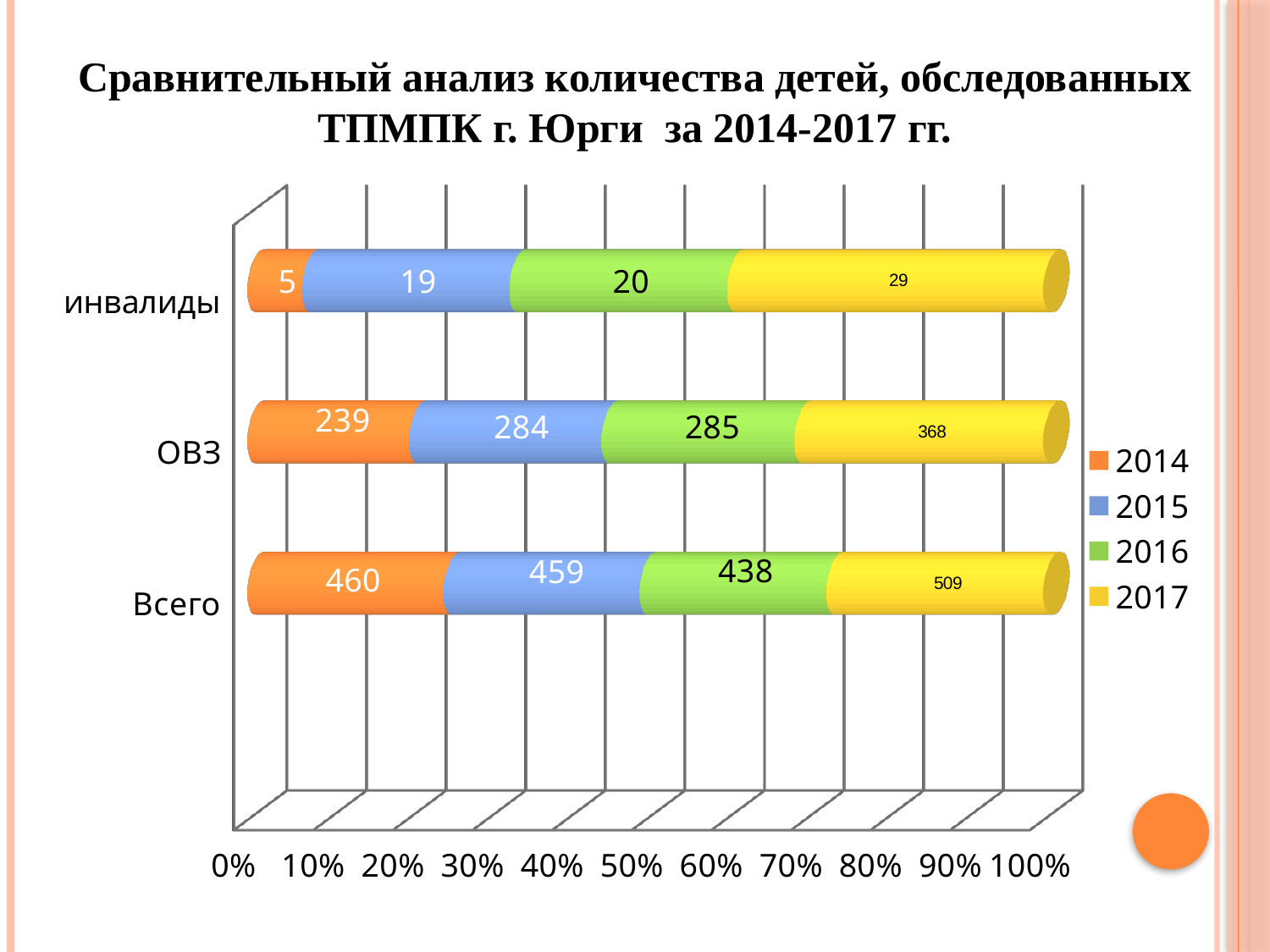
Which colour represents the 2017 series in the legend? Yellow What is the difference between the 2017 and 2014 values in the ОВЗ category? 129 How many categories are shown on the chart? 3 How many series does the legend list? 4 What is the value for 2014 in the инвалиды category? 5 What is the value for 2015 in the Всего category? 459 Which year has the lowest value in the Всего category? 2016 What is the value for 2017 in the Всего category? 509 Which is larger in the инвалиды category: the value for 2016 or the value for 2015? 2016 What is the value for 2016 in the ОВЗ category? 285 What kind of chart is shown on the slide? Stacked bar chart Which year has the highest value in the ОВЗ category? 2017